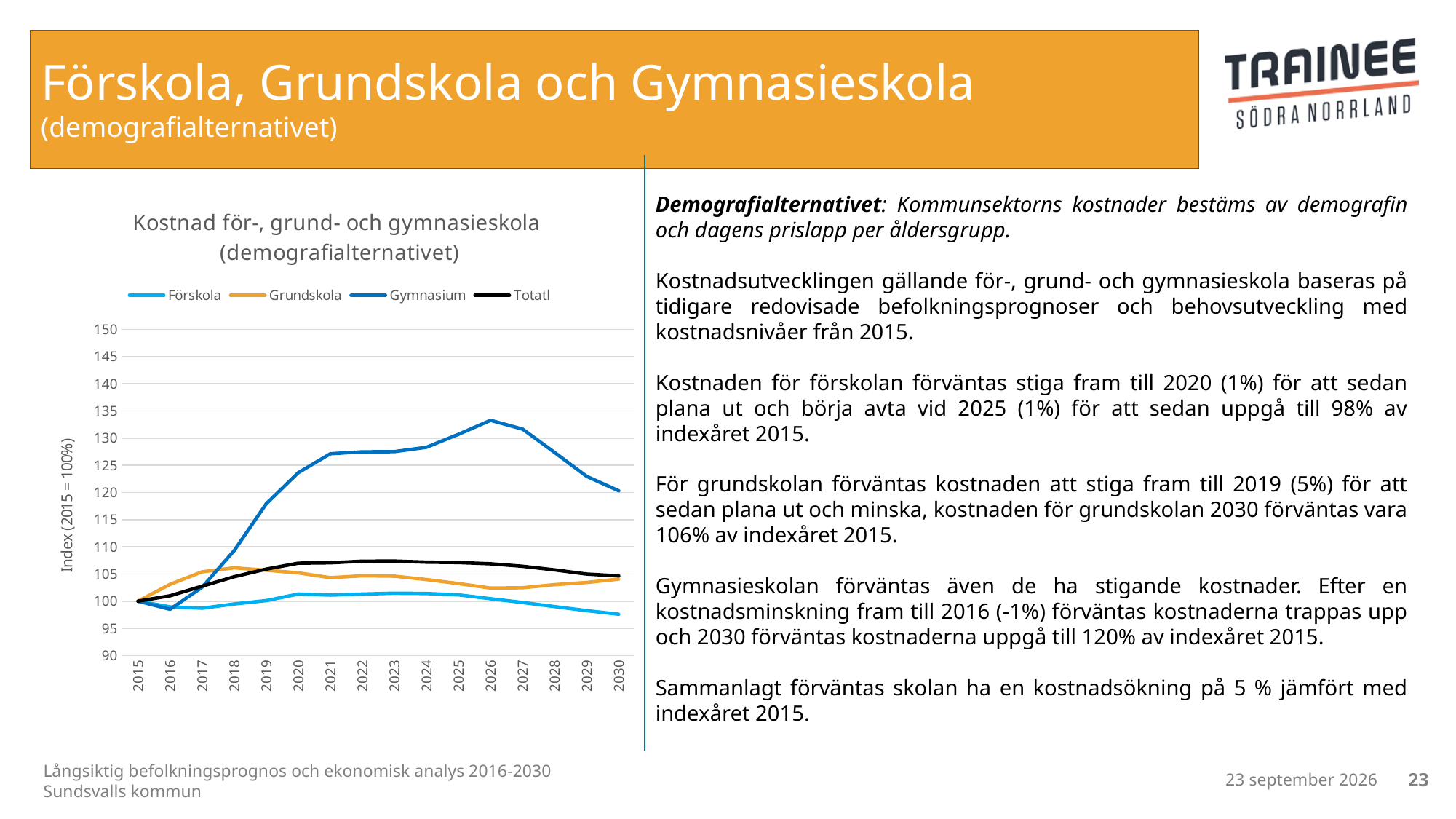
What kind of chart is shown on the slide? line chart Is the value for Totatl in 2022 greater or less than 105? greater Is the value for Gymnasium in 2026 greater or less than 130? greater Which series has the lowest value in 2030? Förskola What is the index value for Gymnasium in 2015? 100 What is the title of the chart? Kostnad för-, grund- och gymnasieskola (demografialternativet) How many years are plotted along the x axis of the chart? 16 How many series does the chart legend list? 4 Which series has the highest value in 2026? Gymnasium Is the value for Förskola in 2030 greater or less than 100? less Which is larger in 2020, the value for Gymnasium or the value for Grundskola? Gymnasium Does the Gymnasium line rise or fall between 2026 and 2030? fall